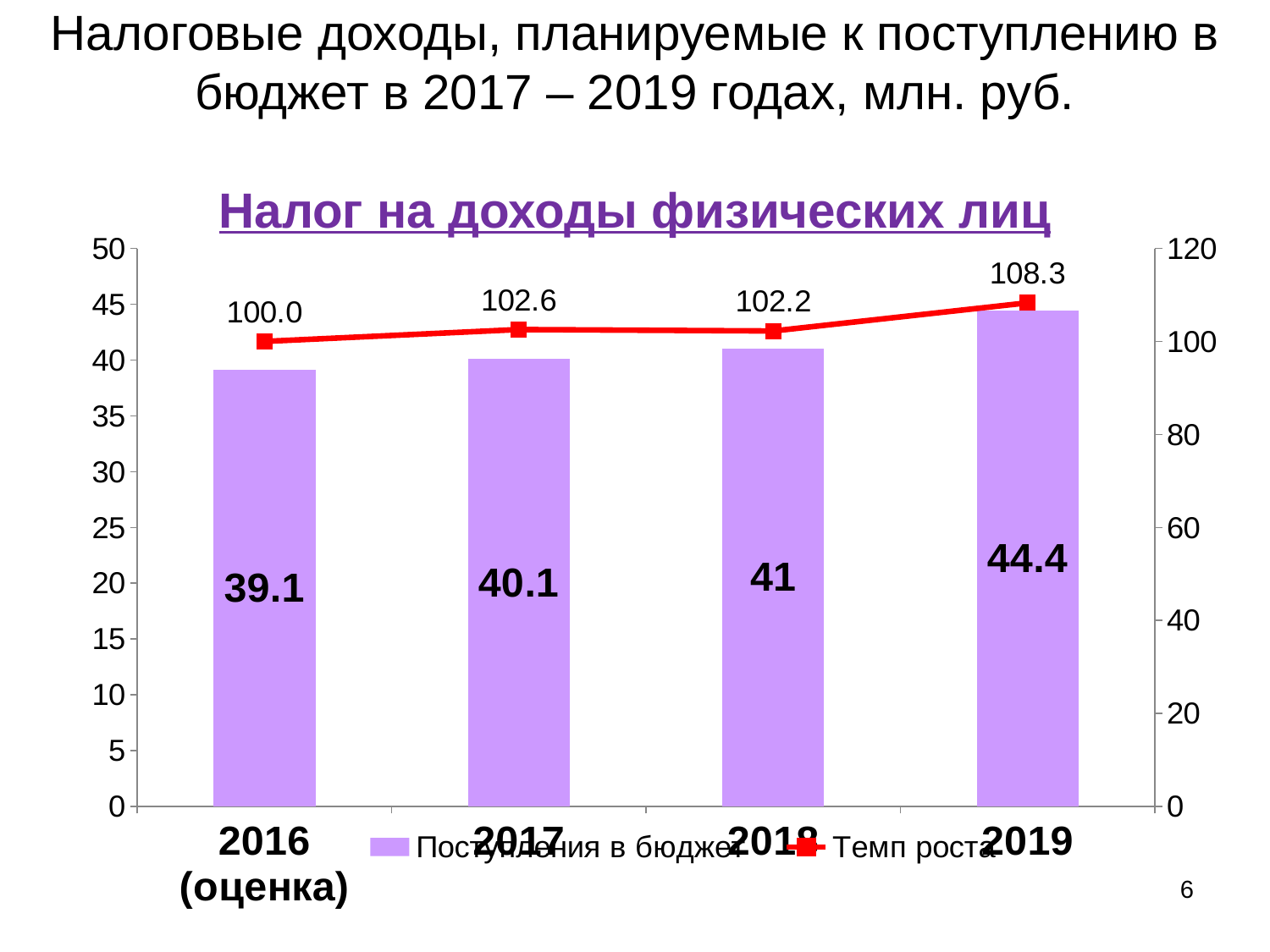
What is the title of the chart? Налог на доходы физических лиц How many series does the legend list? 2 What is the value of Поступления в бюджет for 2017? 40.1 What kind of chart is used for the Поступления в бюджет series? bar chart Do the values of Поступления в бюджет rise or fall from 2016 to 2019? rise Which is larger, Темп роста in 2017 or in 2018? 2017 What is the value of Поступления в бюджет for 2016 (оценка)? 39.1 Which year has the highest value of Поступления в бюджет? 2019 How many years are shown on the x axis? 4 What is the difference between Поступления в бюджет in 2019 and 2018? 3.4 What is the value of Темп роста for 2019? 108.3 Which year has the lowest value of Темп роста? 2016 (оценка)